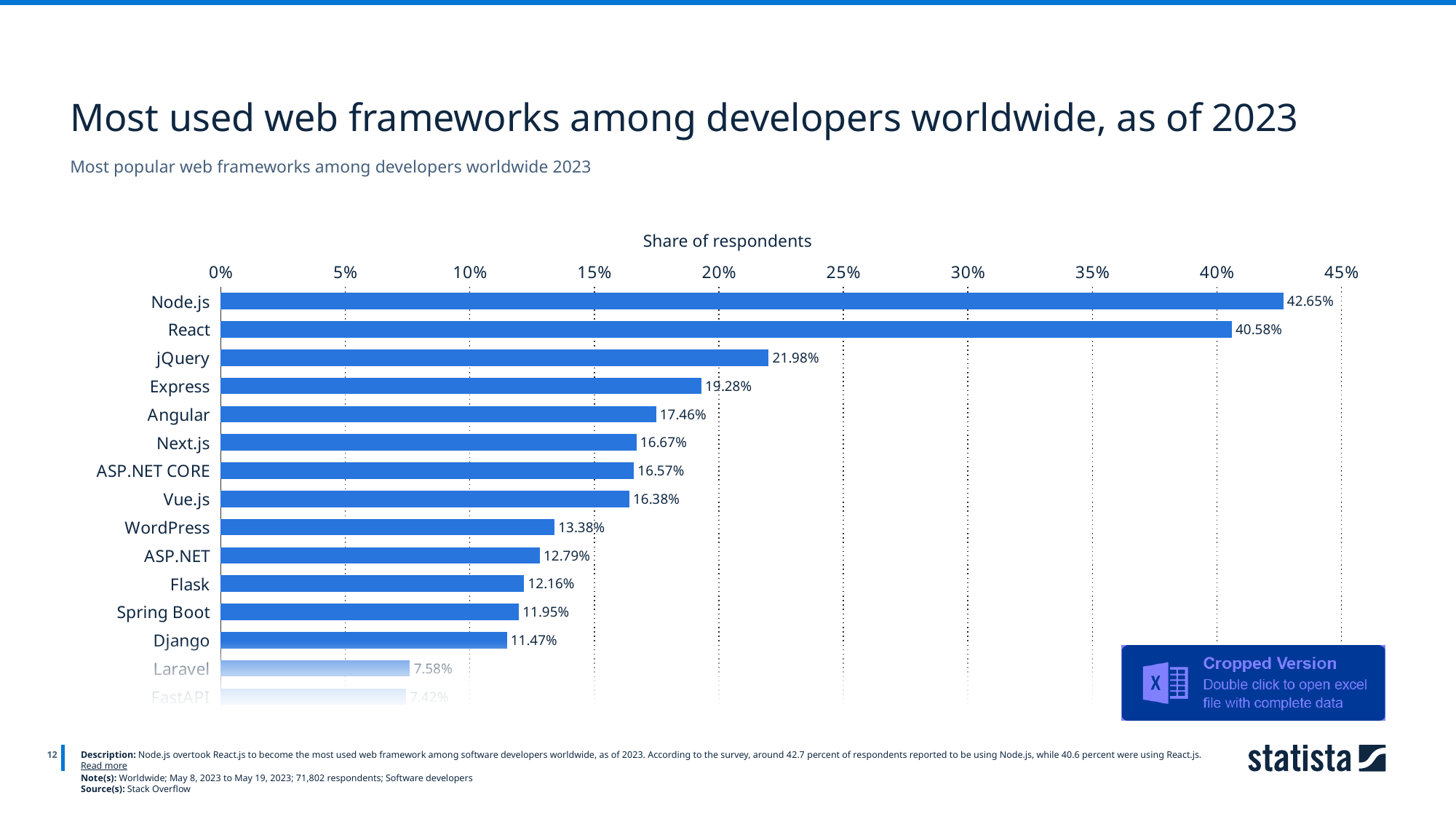
What share of respondents reported using Node.js? 42.65% What is the difference in share between Node.js and React? 2.07% Which has a larger share of respondents, Flask or Express? Express What share of respondents use Django? 11.47% Which has a larger share of respondents, Angular or WordPress? Angular What is the value shown for ASP.NET CORE? 16.57% What is the difference in share between jQuery and Express? 2.70% What is the value shown for jQuery? 21.98% What is the axis title shown above the chart? Share of respondents What kind of chart is shown on the slide? Bar chart Which web framework has the highest share of respondents? Node.js Is the value for React greater or less than 35%? greater